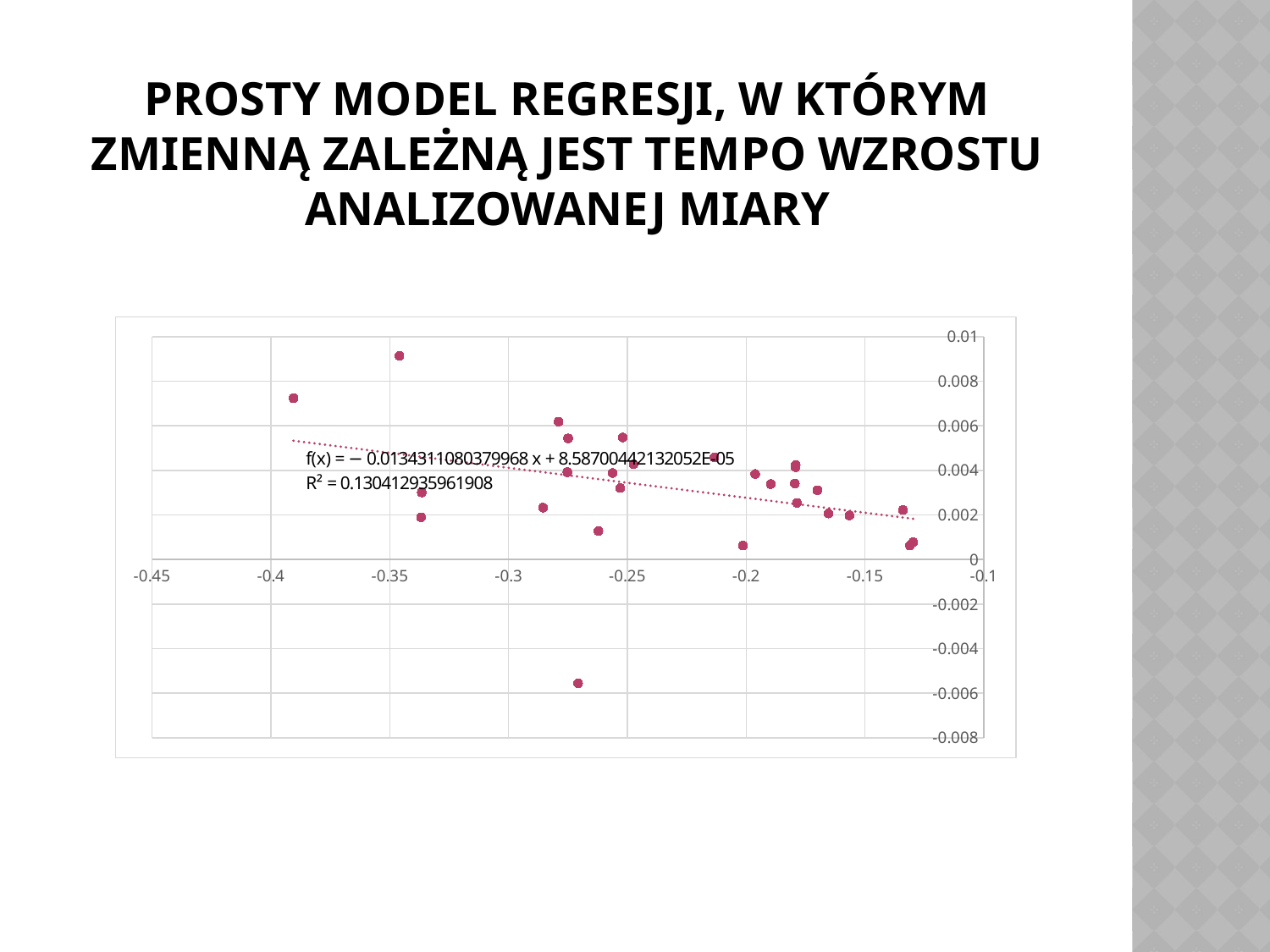
What is the maximum value shown on the y axis? 0.01 Is the y value of the lowest point on the chart greater or less than -0.004? less What is the minimum value shown on the x axis? -0.45 What is the slope coefficient in the regression equation printed on the chart? −0.0134311080379968 What is the R² value printed on the chart? R² = 0.130412935961908 How many points on the chart have a y value below 0? 1 What is the intercept term in the regression equation printed on the chart? 8.58700442132052E-05 Is the y value of the point near x = -0.27 that lies below the x axis greater or less than -0.002? less What kind of chart is shown on the slide? scatter chart Does the trend line on the chart rise or fall as x increases? fall Is the y value of the highest point on the chart greater or less than 0.008? greater